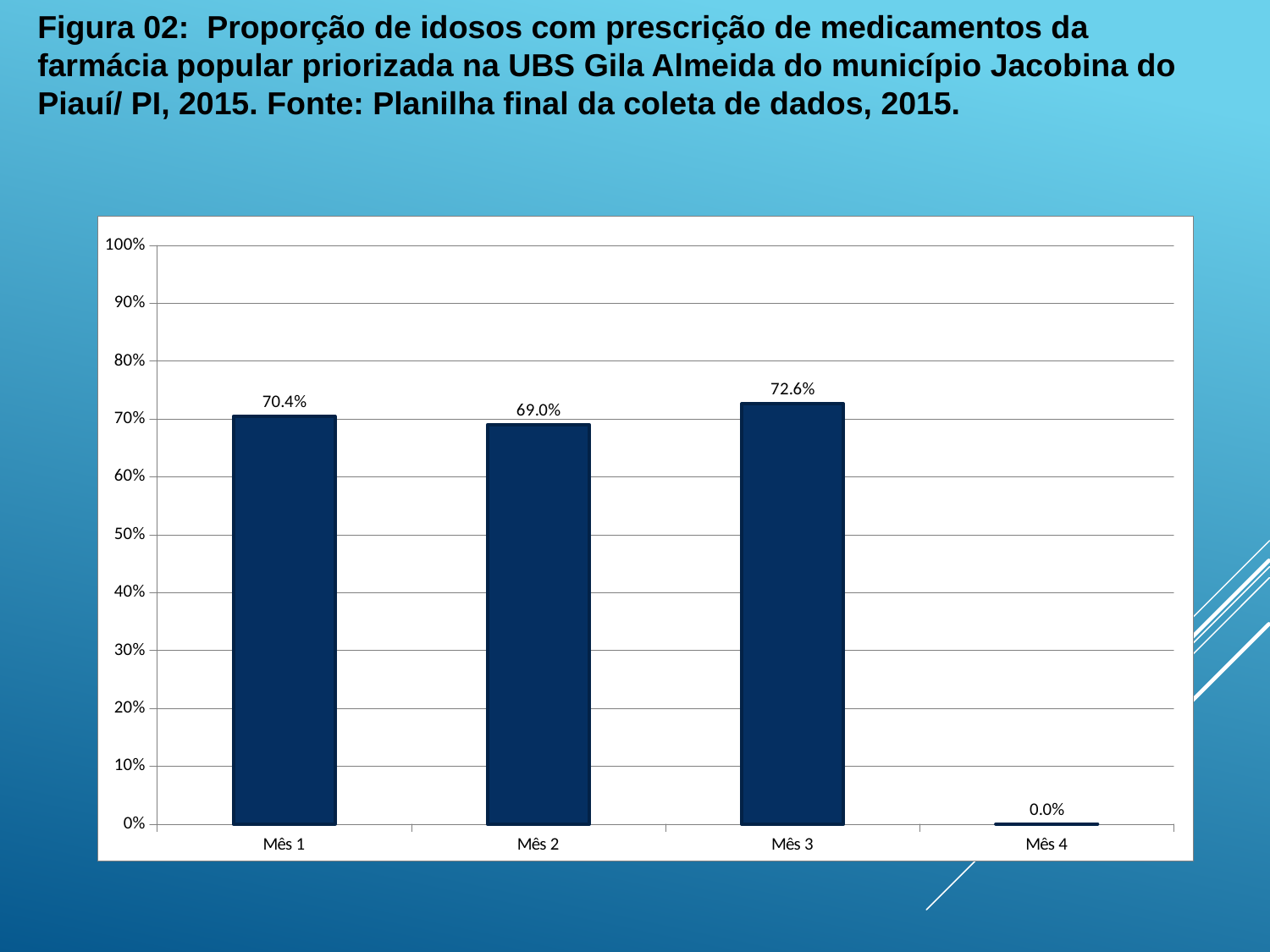
What is the value for Mês 1? 70.4% Is the value for Mês 3 greater or less than 70%? greater What is the value for Mês 2? 69.0% What is the difference between the values for Mês 1 and Mês 2? 1.4% What kind of chart is shown on the slide? bar chart Which month has the highest value? Mês 3 Which is larger, the value for Mês 1 or the value for Mês 2? Mês 1 What is the value for Mês 4? 0.0% What is the value for Mês 3? 72.6% How many months are shown on the x axis? 4 Which month has the lowest value? Mês 4 What is the difference between the values for Mês 3 and Mês 2? 3.6%